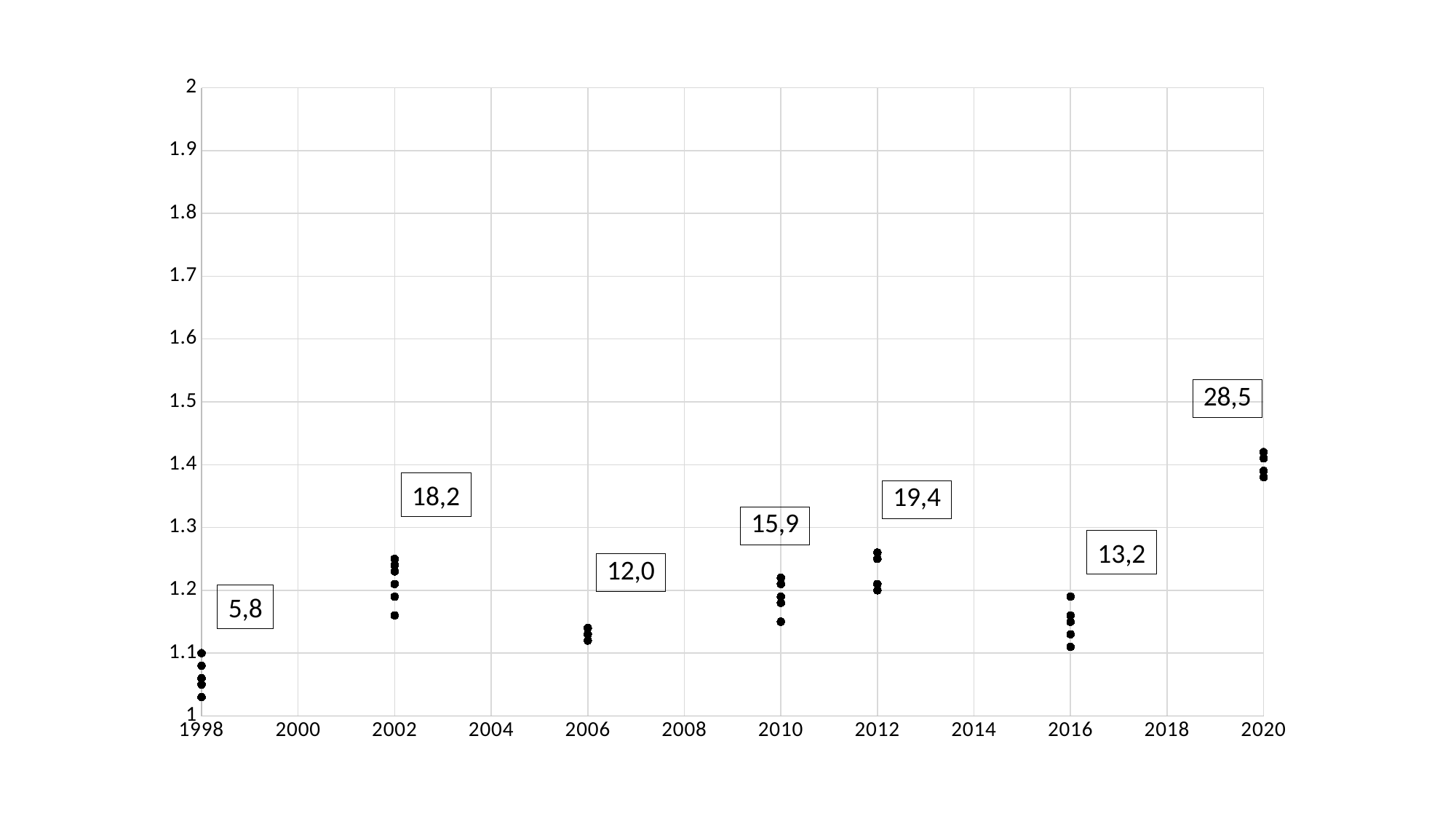
Which year has the lowest plotted points? 1998 Which year has the highest plotted points? 2020 What value is shown in the label box next to the 1998 points? 5,8 Are the plotted values for 2006 greater or less than 1.2? less What value is shown in the label box above the 2020 points? 28,5 Are the plotted points for 2020 higher or lower than those for 2016? higher Are the plotted values for 2012 greater or less than 1.1? greater Are the plotted values for 1998 greater or less than 1.2? less What is the highest value shown on the vertical axis? 2 How many years have data points plotted on the chart? 7 What kind of chart is shown on the slide? scatter chart